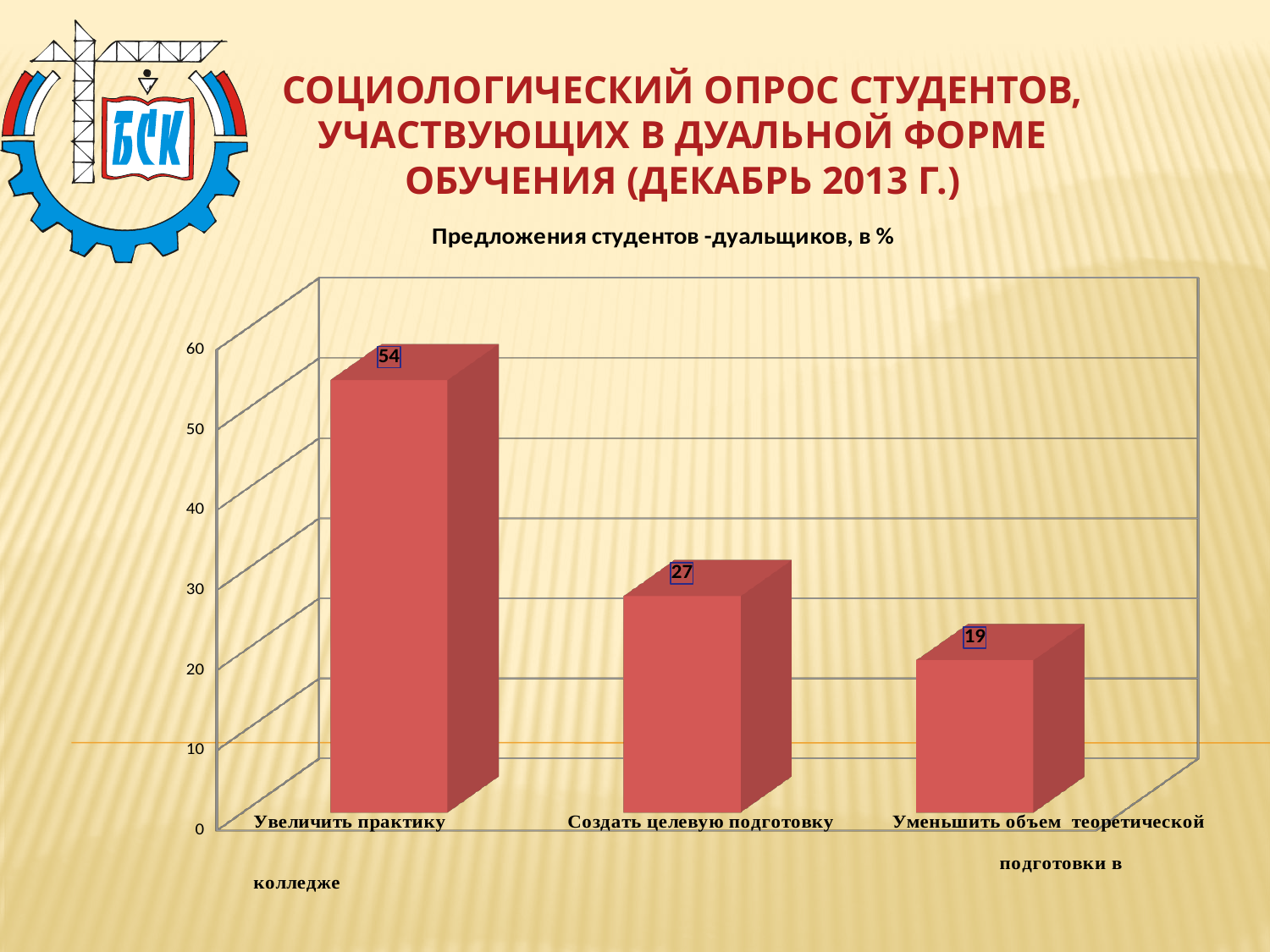
Which category has the highest value? Увеличить практику How many categories are shown in the chart? 3 Is the value for "Увеличить практику" greater or less than 50? greater Which is larger, the value for "Создать целевую подготовку" or the value for "Уменьшить объем теоретической подготовки в колледже"? Создать целевую подготовку What is the value for "Создать целевую подготовку"? 27 What is the title of the chart? Предложения студентов -дуальщиков, в % What is the value for "Уменьшить объем теоретической подготовки в колледже"? 19 What is the value for "Увеличить практику"? 54 Which category has the lowest value? Уменьшить объем теоретической подготовки в колледже What kind of chart is shown on the slide? bar chart What is the difference between the values for "Увеличить практику" and "Создать целевую подготовку"? 27 What is the difference between the values for "Создать целевую подготовку" and "Уменьшить объем теоретической подготовки в колледже"? 8